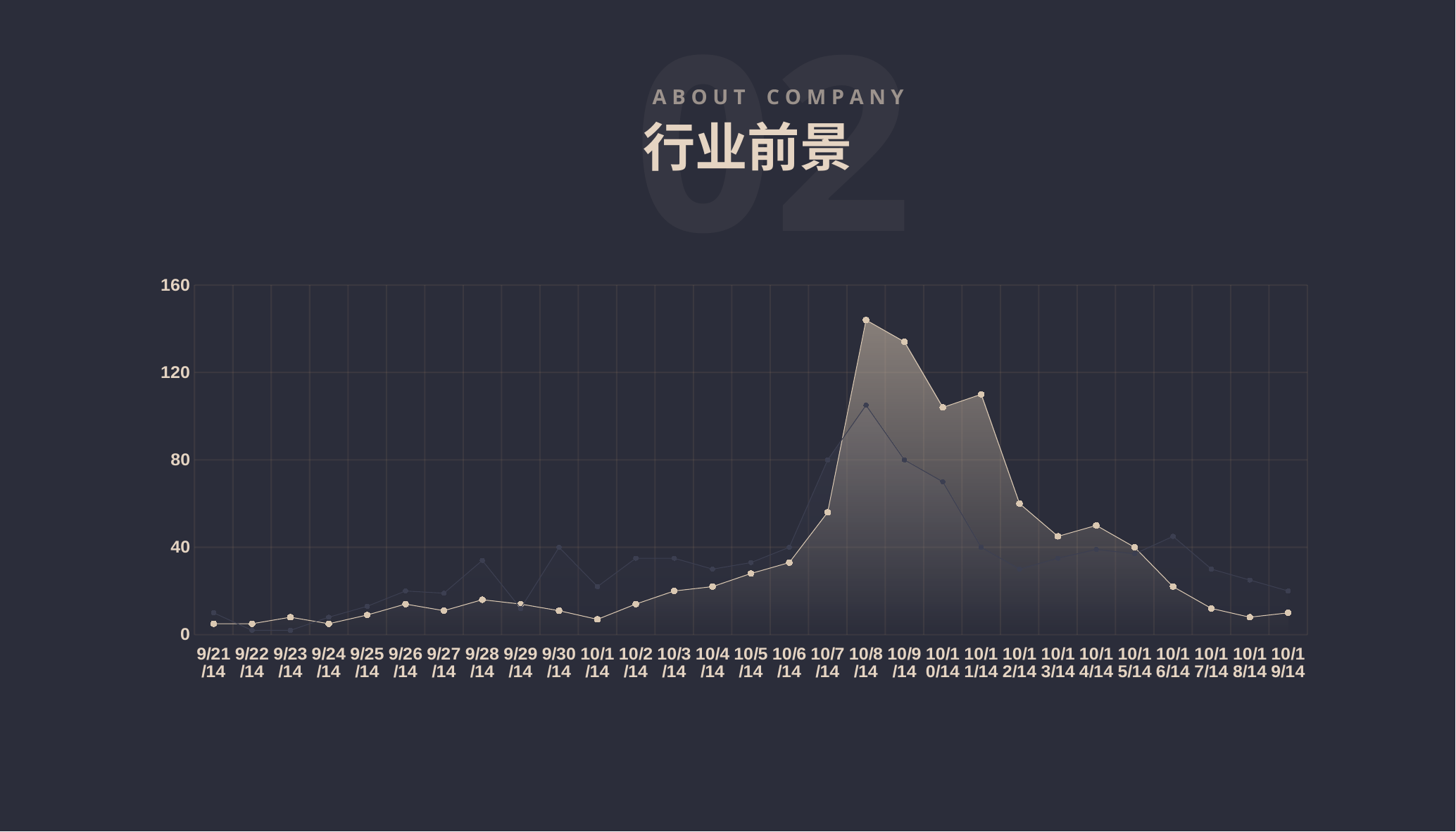
Is the value of the shaded series on 9/21/14 greater or less than 40? less Is the value of the thin dark line series on 10/8/14 greater or less than 80? greater Is the value of the shaded series on 10/8/14 greater or less than 120? greater On which date does the shaded (filled) series reach its highest value? 10/8/14 What is the highest value shown on the y axis of the chart? 160 For the shaded series, which date has the larger value: 10/8/14 or 10/11/14? 10/8/14 Does the shaded series rise or fall from 10/8/14 to 10/19/14? fall What kind of chart is shown on the slide? combination area and line chart What is the title shown above the chart on the slide? 行业前景 How many dates are plotted along the x axis of the chart? 29